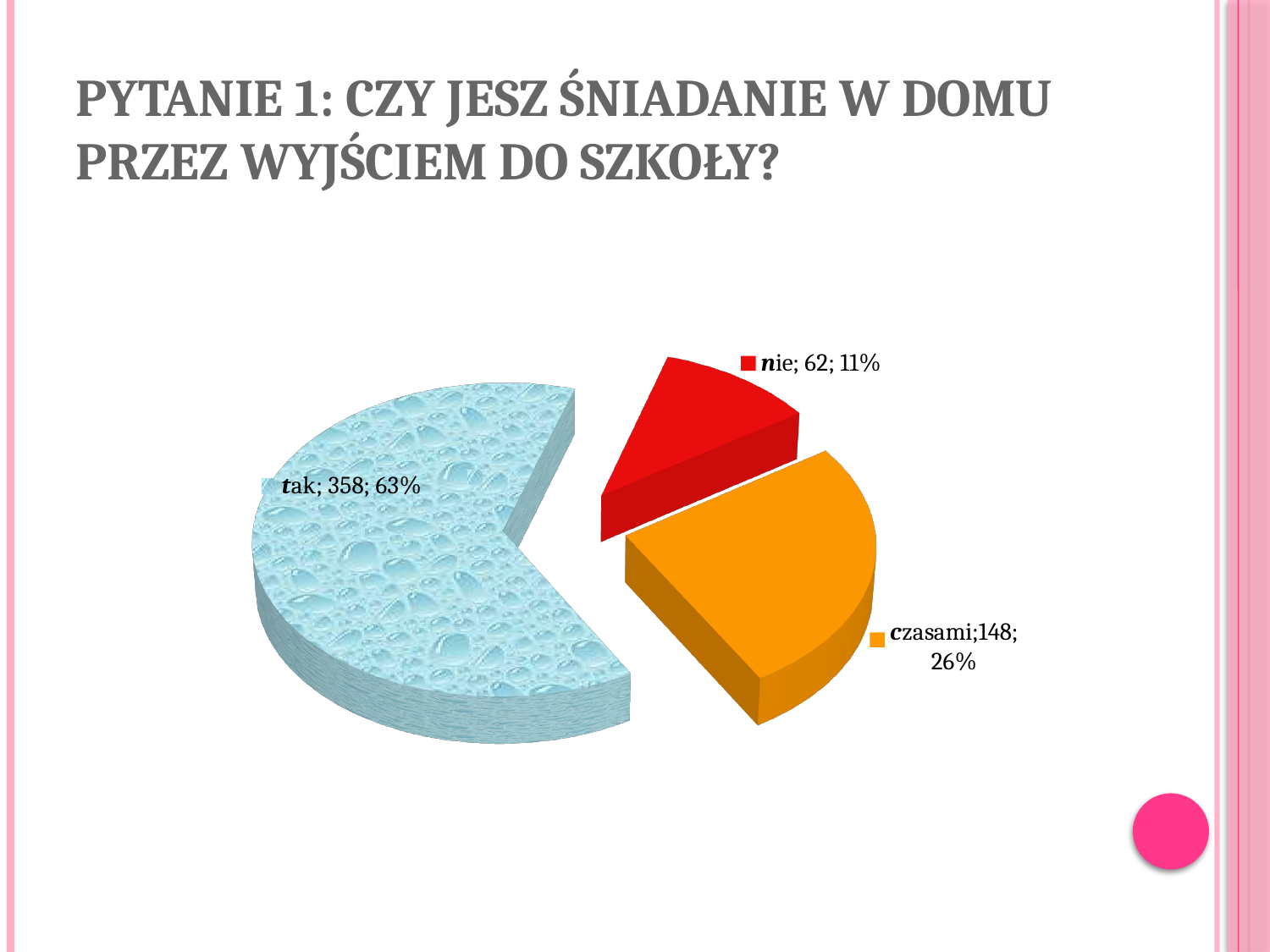
What share of the pie does "czasami" represent? 26% What is the value for "tak"? 358 What is the difference between the values for "tak" and "czasami"? 210 What is the value for "czasami"? 148 What kind of chart is shown on the slide? pie chart How many slices does the pie chart have? 3 Which category has the smallest slice? nie What is the value for "nie"? 62 Which is larger, the value for "czasami" or the value for "nie"? czasami What share of the pie does "tak" represent? 63% Which category has the largest slice? tak What share of the pie does "nie" represent? 11%